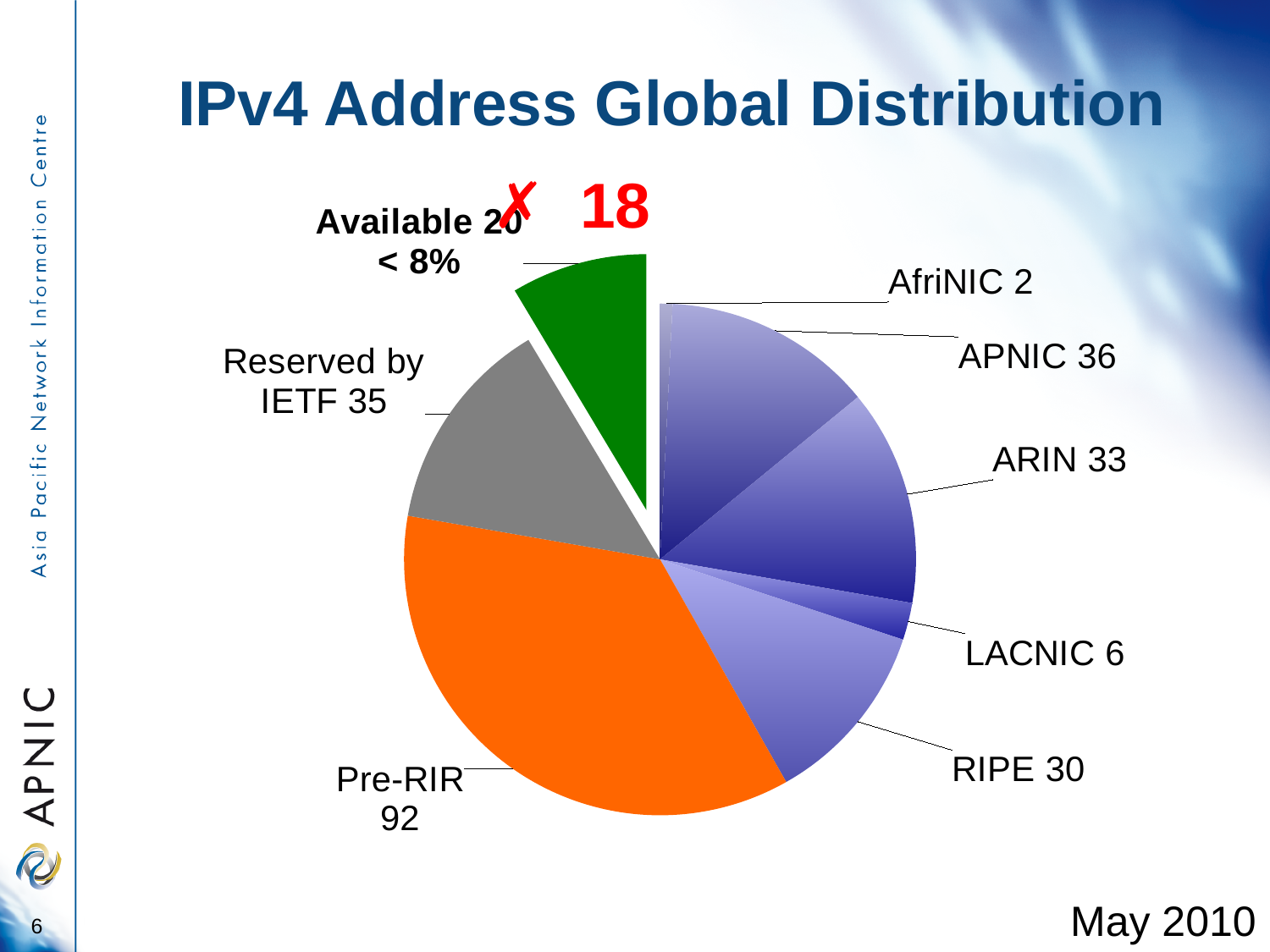
How many slices does the pie chart have? 8 What is the difference between the Pre-RIR and RIPE values? 62 Which slice is coloured green and pulled out from the pie? Available What is the value for LACNIC? 6 Which slice has the smallest value? AfriNIC What is the difference between the APNIC and ARIN values? 3 What is the value for APNIC? 36 Which is larger, the value for ARIN or the value for RIPE? ARIN Which slice has the largest value? Pre-RIR What is the value for Pre-RIR? 92 What kind of chart is shown on the slide? pie chart What is the value for Reserved by IETF? 35